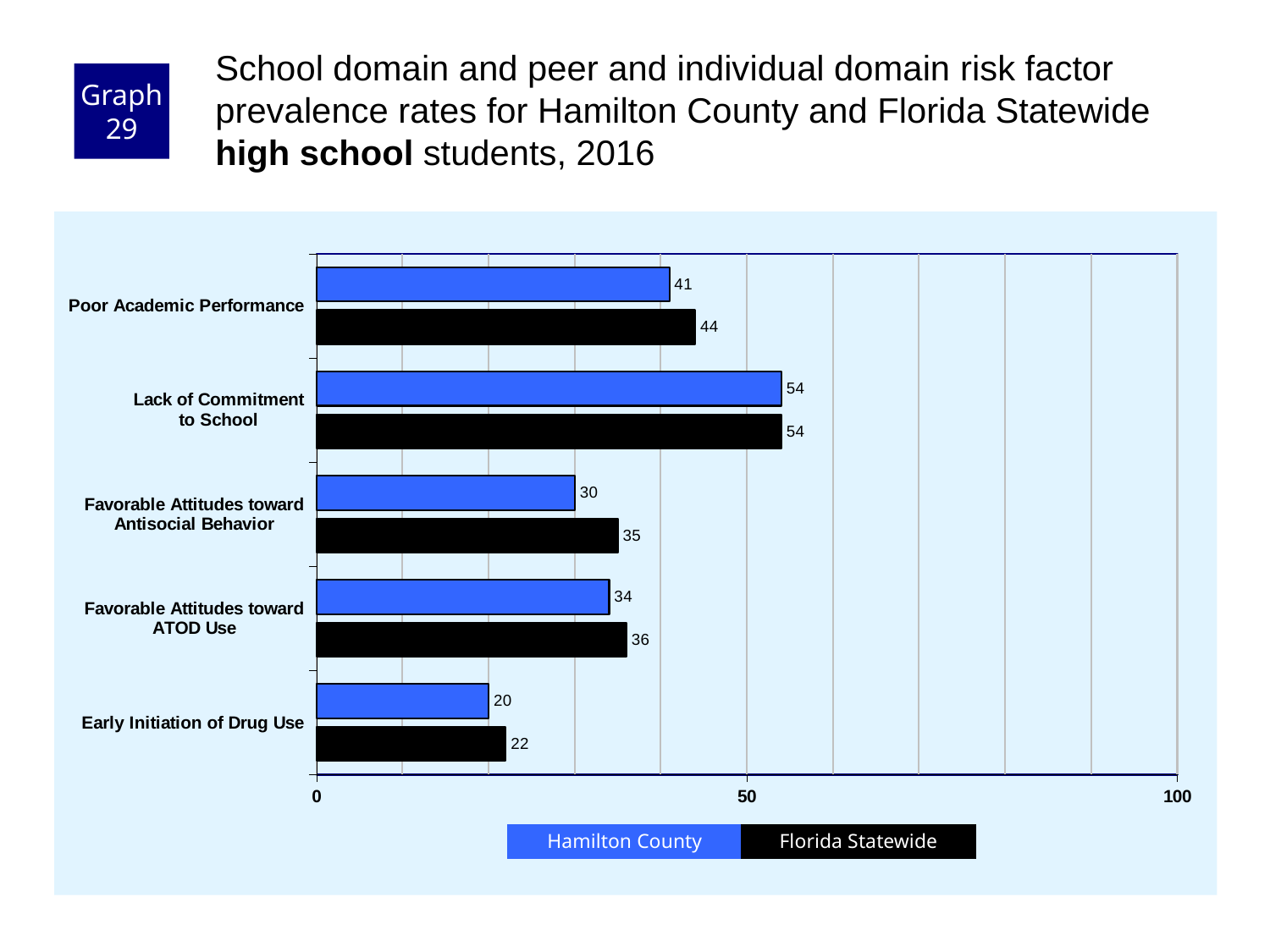
Is the Hamilton County value for Lack of Commitment to School greater or less than 50? greater How many series does the legend list? 2 What is the Hamilton County value for Poor Academic Performance? 41 What is the Florida Statewide value for Favorable Attitudes toward Antisocial Behavior? 35 What is the difference between the Florida Statewide and Hamilton County values for Poor Academic Performance? 3 What kind of chart is shown on the slide? bar chart What is the difference between the Florida Statewide and Hamilton County values for Favorable Attitudes toward Antisocial Behavior? 5 Which risk factor has the lowest Hamilton County value? Early Initiation of Drug Use For Favorable Attitudes toward ATOD Use, which is larger: the Hamilton County value or the Florida Statewide value? Florida Statewide How many risk factor categories are shown on the chart? 5 Which risk factor has the highest Florida Statewide value? Lack of Commitment to School What is the Hamilton County value for Early Initiation of Drug Use? 20